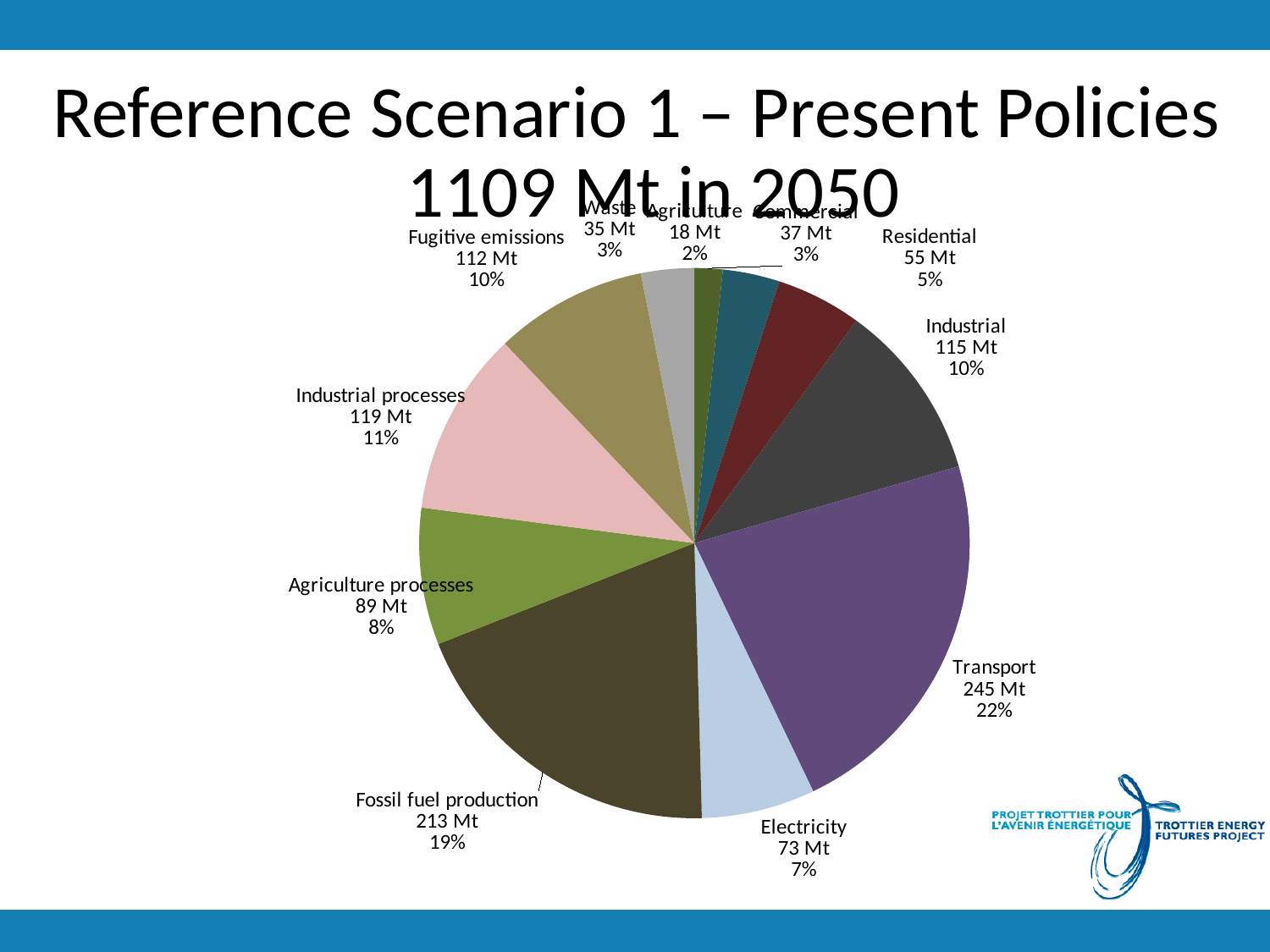
How many slices does the pie chart have? 11 What is the difference between the Transport and Fossil fuel production values? 32 Mt What total is stated in the chart title for 2050? 1109 Mt What share of the pie does Agriculture processes represent? 8% What is the value for Transport? 245 Mt What is the value for Industrial processes? 119 Mt Which is larger, Industrial processes or Fugitive emissions? Industrial processes What share of the pie does Fossil fuel production represent? 19% What is the value for Fossil fuel production? 213 Mt What kind of chart is shown on the slide? Pie chart Which category has the largest slice of the pie? Transport What is the value for Electricity? 73 Mt